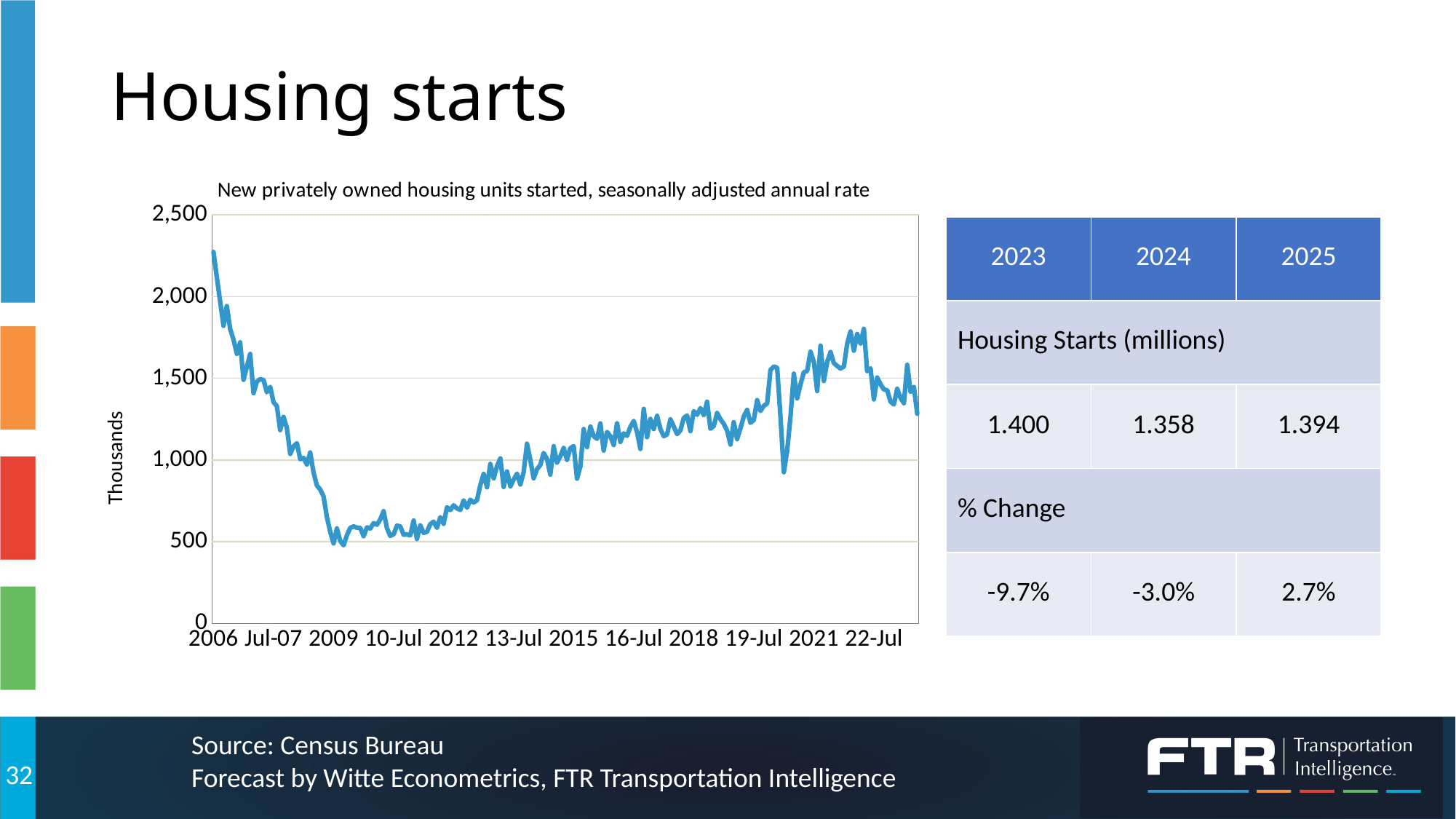
What is the label on the vertical axis of the chart? Thousands What kind of chart is shown on the slide? line chart Is the value at 2018 greater or less than 1,000? greater Do the values rise or fall between 2006 and 2009? fall Is the value at 2021 greater or less than 1,000? greater Is the value at 2012 greater or less than 1,000? less Around which x-axis label does the line reach its highest point? 2006 Do the values rise or fall between 2012 and 2018? rise What is the title of the chart? New privately owned housing units started, seasonally adjusted annual rate Around which x-axis label does the line reach its lowest point? 2009